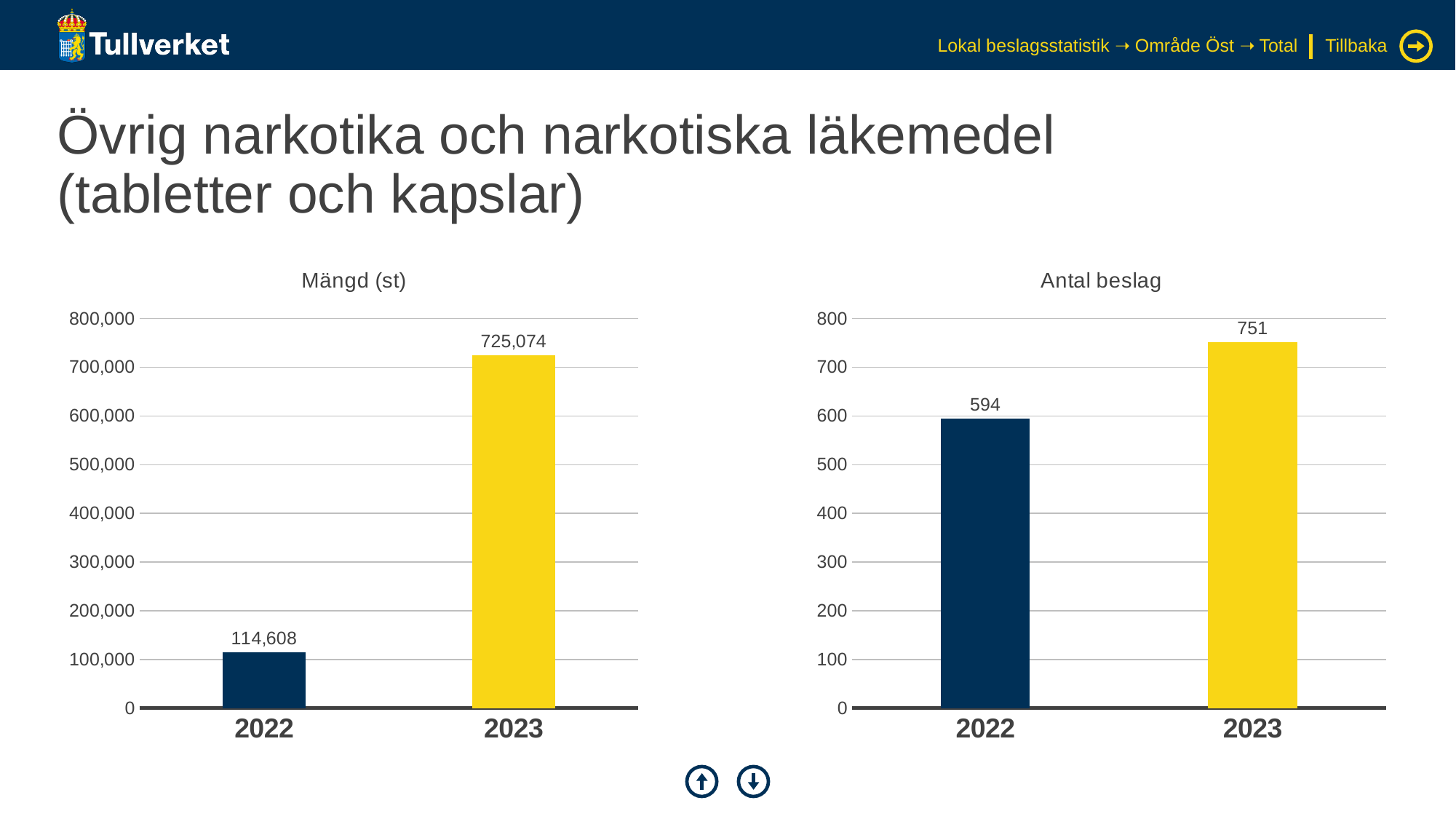
In the 'Mängd (st)' chart, what is the value for 2022? 114,608 In the 'Mängd (st)' chart, what is the difference between the 2023 and 2022 values? 610,466 In the 'Mängd (st)' chart, do the values rise or fall from 2022 to 2023? Rise In the 'Antal beslag' chart, is the value for 2022 greater or less than 500? greater In the 'Mängd (st)' chart, how many years are shown on the x axis? 2 In the 'Mängd (st)' chart, which year has the highest value? 2023 In the 'Mängd (st)' chart, what is the value for 2023? 725,074 In the 'Antal beslag' chart, what is the value for 2023? 751 In the 'Antal beslag' chart, which year has the lowest value? 2022 What kind of chart is the 'Antal beslag' chart? Bar chart In the 'Antal beslag' chart, what is the value for 2022? 594 In the 'Antal beslag' chart, what is the difference between the 2023 and 2022 values? 157